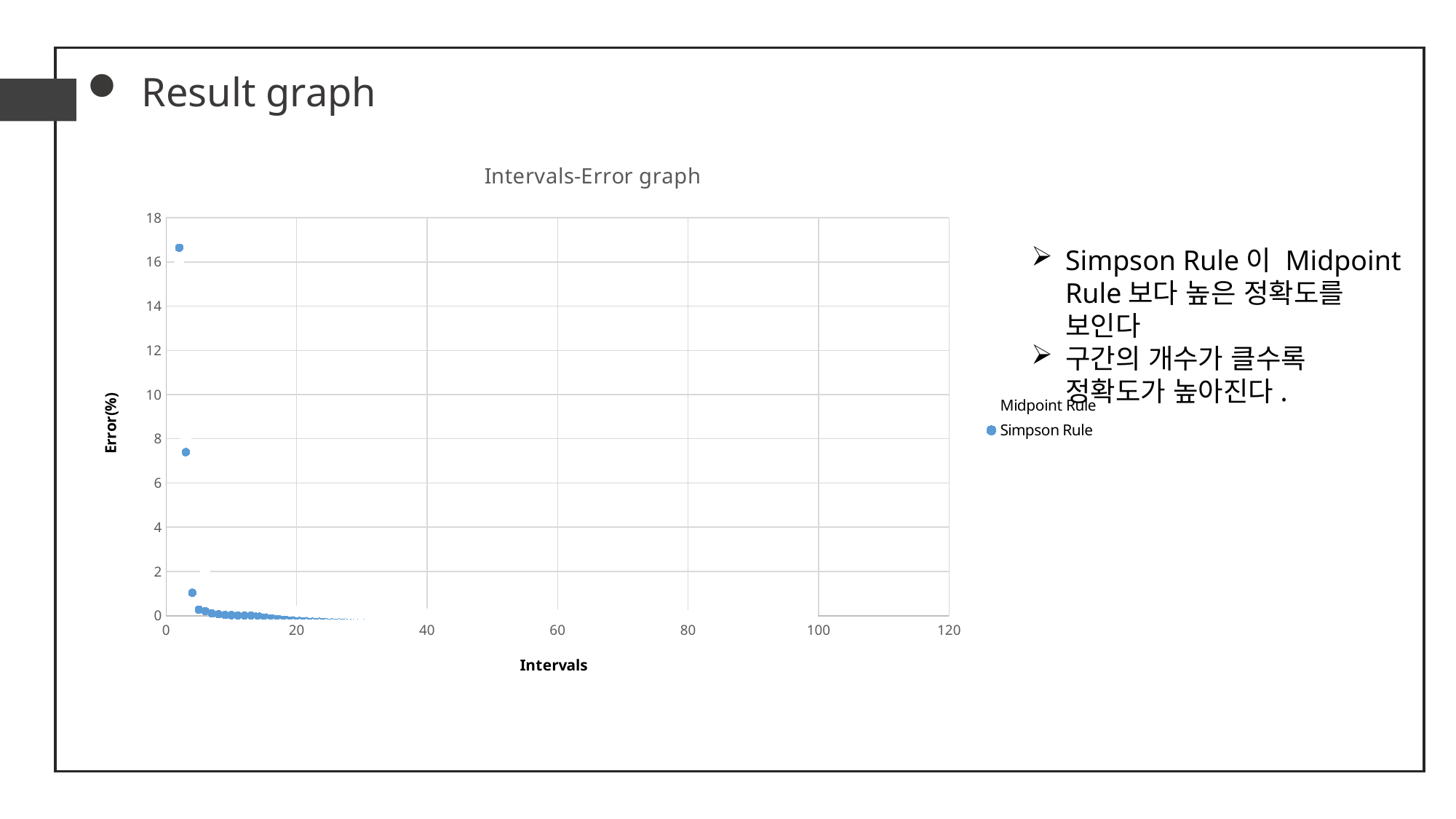
Is the second-highest plotted error value greater or less than 8? less Is the highest plotted error value greater or less than 16? greater What kind of chart is shown on the slide? scatter chart Is the second-highest plotted error value greater or less than 6? greater What is the label of the y axis? Error(%) What is the maximum value shown on the y axis? 18 What are the names of the series listed in the chart legend? Midpoint Rule, Simpson Rule How many series does the chart legend list? 2 Do the error values rise or fall as the number of intervals increases? fall